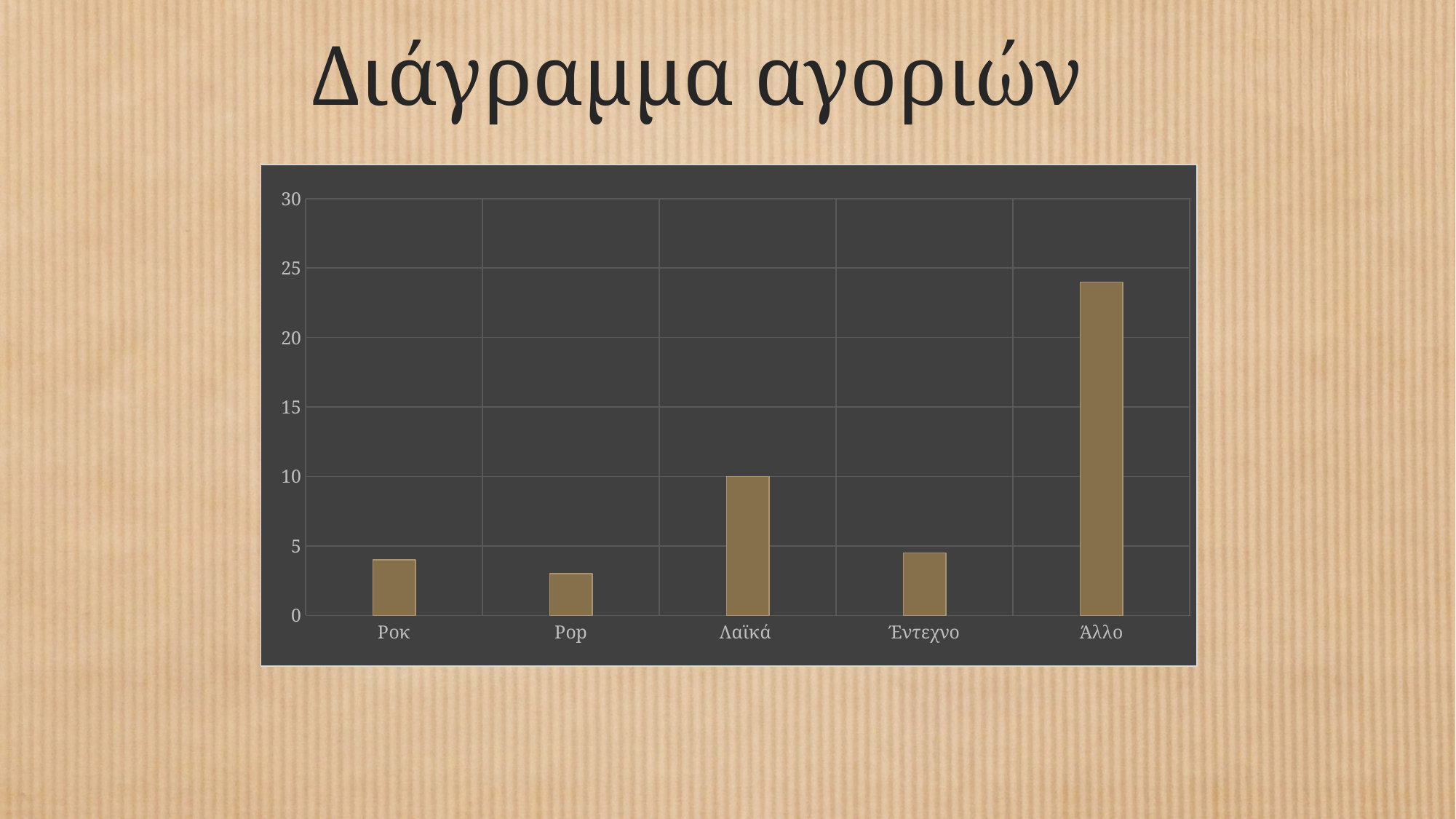
Is the value for Ροκ greater or less than 5? less Which is larger, the value for Λαϊκά or the value for Έντεχνο? Λαϊκά Which category has the lowest value? Pop Is the value for Άλλο greater or less than 25? less Is the value for Pop greater or less than 5? less What is the title of the slide? Διάγραμμα αγοριών Which is larger, the value for Άλλο or the value for Λαϊκά? Άλλο Which category has the highest value? Άλλο What is the value for Λαϊκά? 10 What kind of chart is shown on the slide? bar chart How many categories are shown on the x axis of the chart? 5